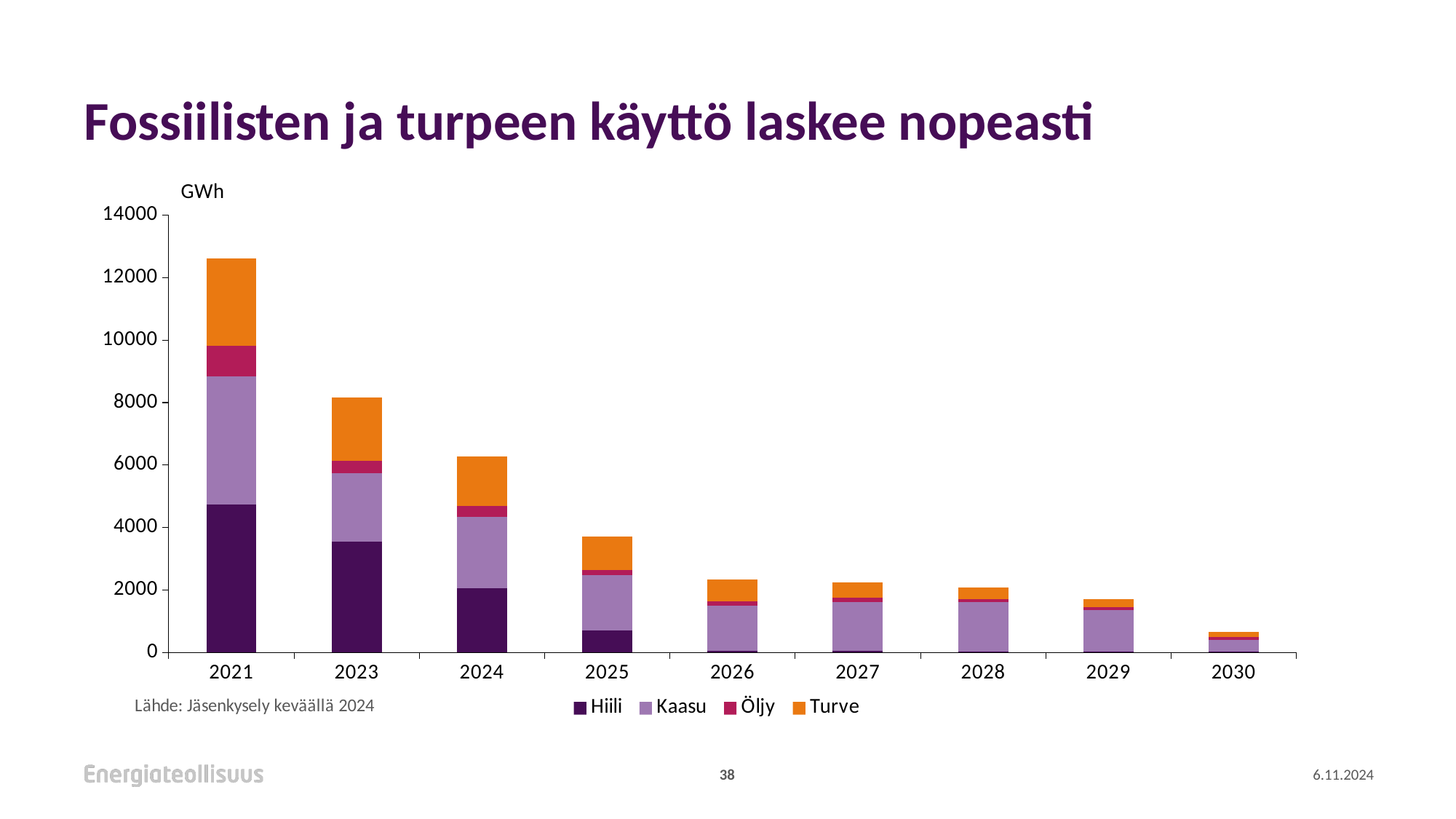
Which year has the larger total bar, 2023 or 2025? 2023 How many years are shown on the x axis? 9 Do the total values rise or fall from 2021 to 2030? Fall Which year has the highest total bar? 2021 How many series does the legend list? 4 What kind of chart is shown on the slide? Stacked bar chart Is the total value for 2030 greater or less than 2000? less Which year has the lowest total bar? 2030 Is the total value for 2025 greater or less than 4000? less What unit is shown above the y axis? GWh Is the total value for 2021 greater or less than 12000? greater